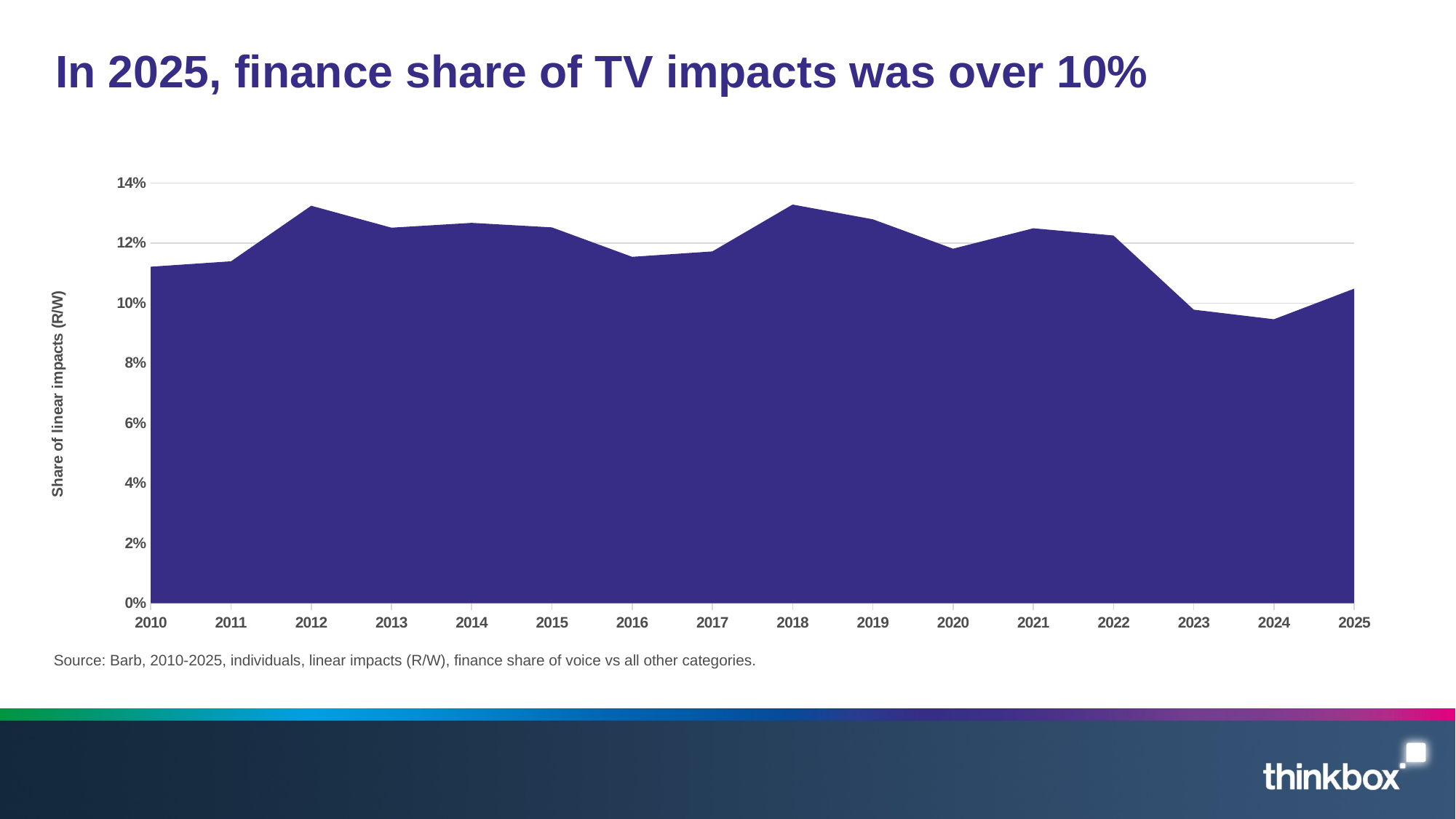
Is the value for 2025 greater or less than 10%? greater Does the value rise or fall from 2022 to 2024? fall What kind of chart is shown on the slide? Area chart Which year has the larger value, 2022 or 2023? 2022 Which year has the larger value, 2012 or 2024? 2012 Is the value for 2024 greater or less than 10%? less How many years are plotted along the x axis? 16 Is the value for 2012 greater or less than 12%? greater What is the label on the vertical axis? Share of linear impacts (R/W) Does the value rise or fall from 2024 to 2025? rise